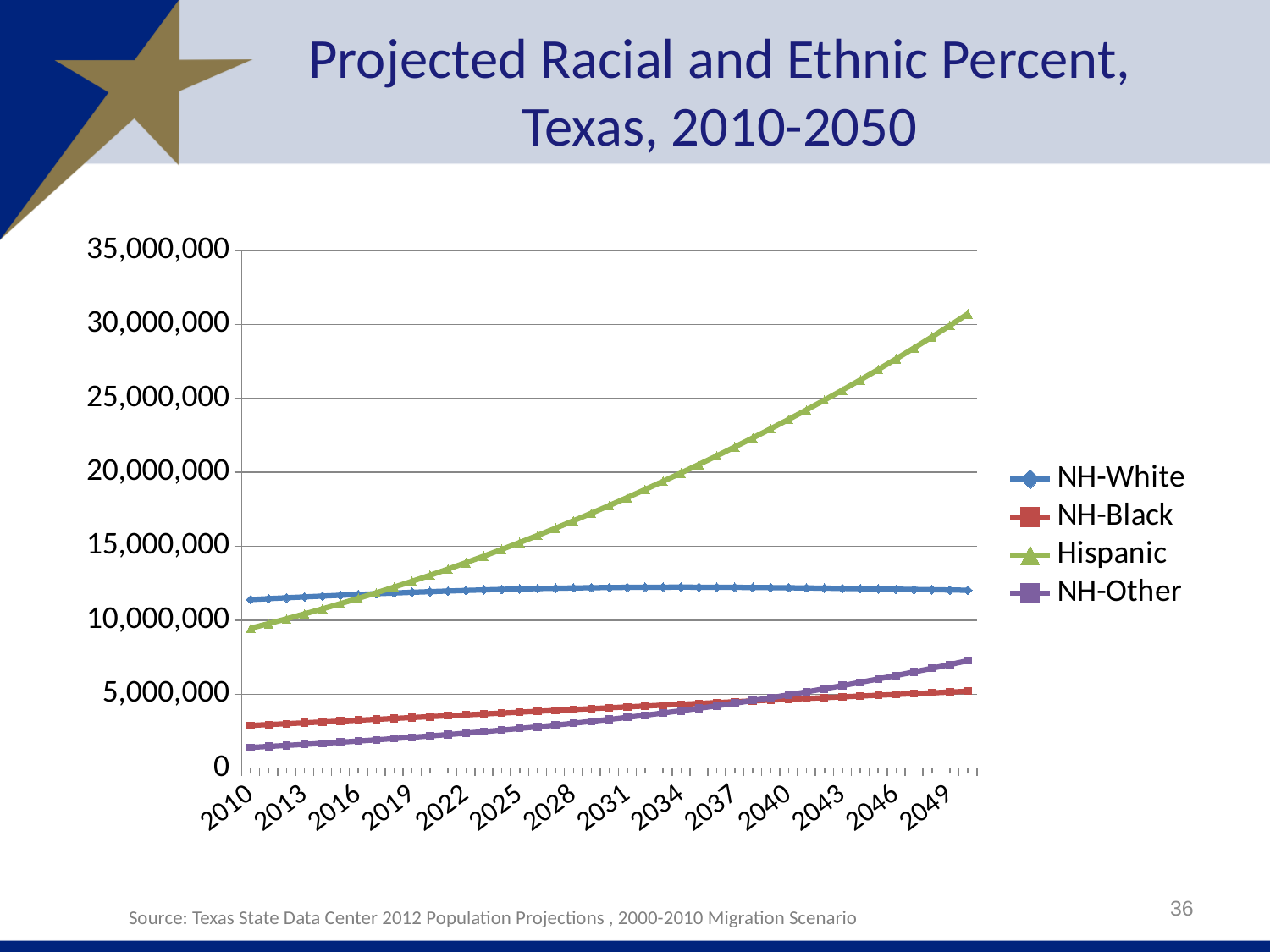
Which series has the highest value in 2010? NH-White In 2050, which is larger: NH-Other or NH-Black? NH-Other Does the Hispanic series rise or fall from 2010 to 2050? rise Is the value for Hispanic in 2010 greater or less than 10,000,000? less Which series has the lowest value in 2010? NH-Other Is the value for Hispanic in 2050 greater or less than 25,000,000? greater What is the title of the chart? Projected Racial and Ethnic Percent, Texas, 2010-2050 Which series has the highest value in 2050? Hispanic In 2010, which is larger: NH-Black or NH-Other? NH-Black How many series does the legend list? 4 Is the value for NH-Other in 2050 greater or less than 5,000,000? greater What kind of chart is shown on the slide? line chart